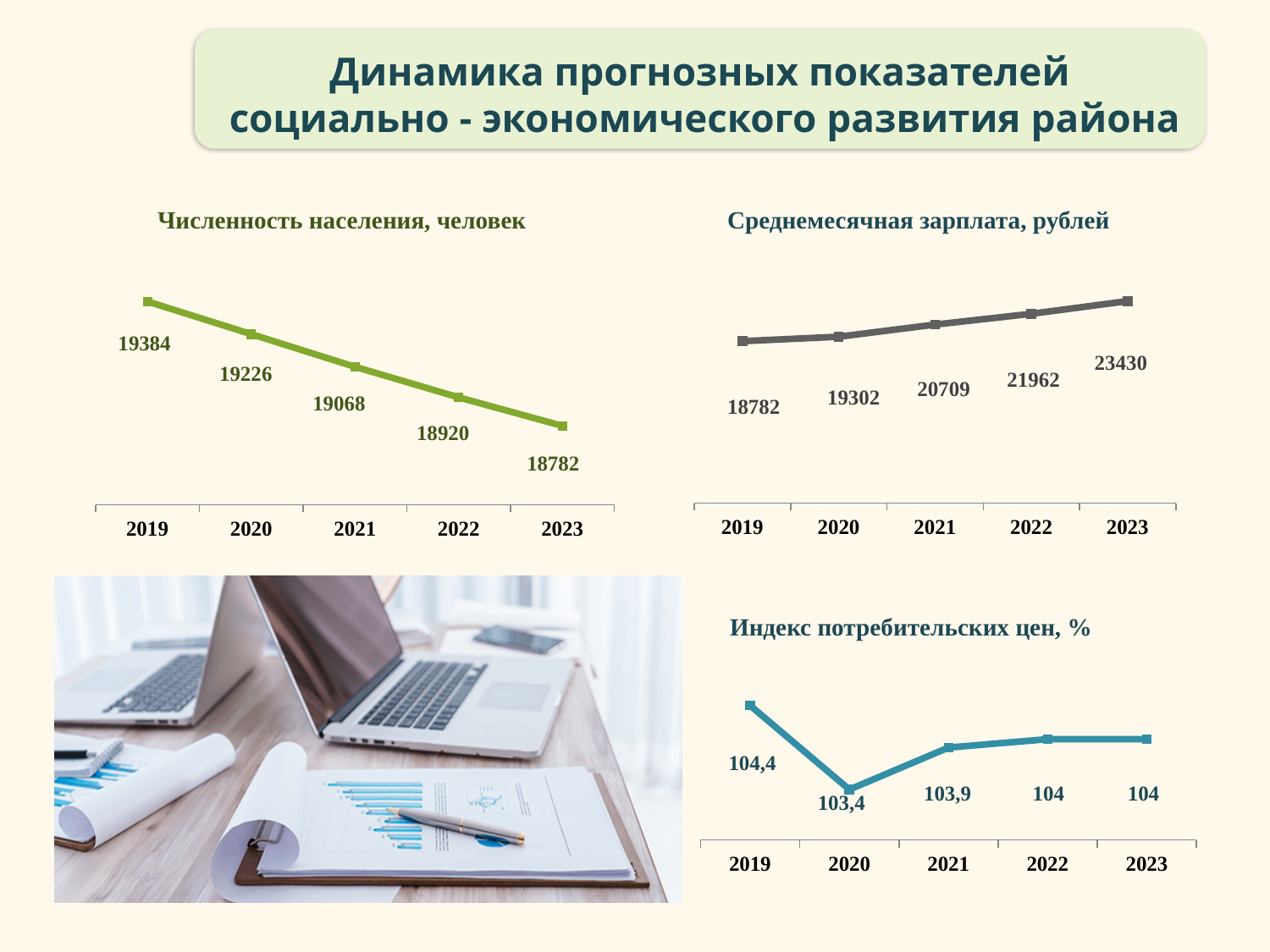
In the chart titled "Среднемесячная зарплата, рублей", what is the value for 2023? 23430 In the chart titled "Численность населения, человек", what is the difference between the 2019 and 2023 values? 602 In the chart titled "Среднемесячная зарплата, рублей", what is the difference between the 2022 and 2021 values? 1253 In the chart titled "Индекс потребительских цен, %", which is larger, the value for 2019 or the value for 2021? 2019 In the chart titled "Численность населения, человек", which year has the lowest value? 2023 In the chart titled "Среднемесячная зарплата, рублей", which year has the highest value? 2023 In the chart titled "Индекс потребительских цен, %", which year has the highest value? 2019 In the chart titled "Численность населения, человек", do the values rise or fall from 2019 to 2023? fall In the chart titled "Численность населения, человек", what is the value for 2019? 19384 What kind of chart is the chart titled "Индекс потребительских цен, %"? line chart In the chart titled "Индекс потребительских цен, %", what is the value for 2020? 103,4 In the chart titled "Среднемесячная зарплата, рублей", how many data points are plotted? 5